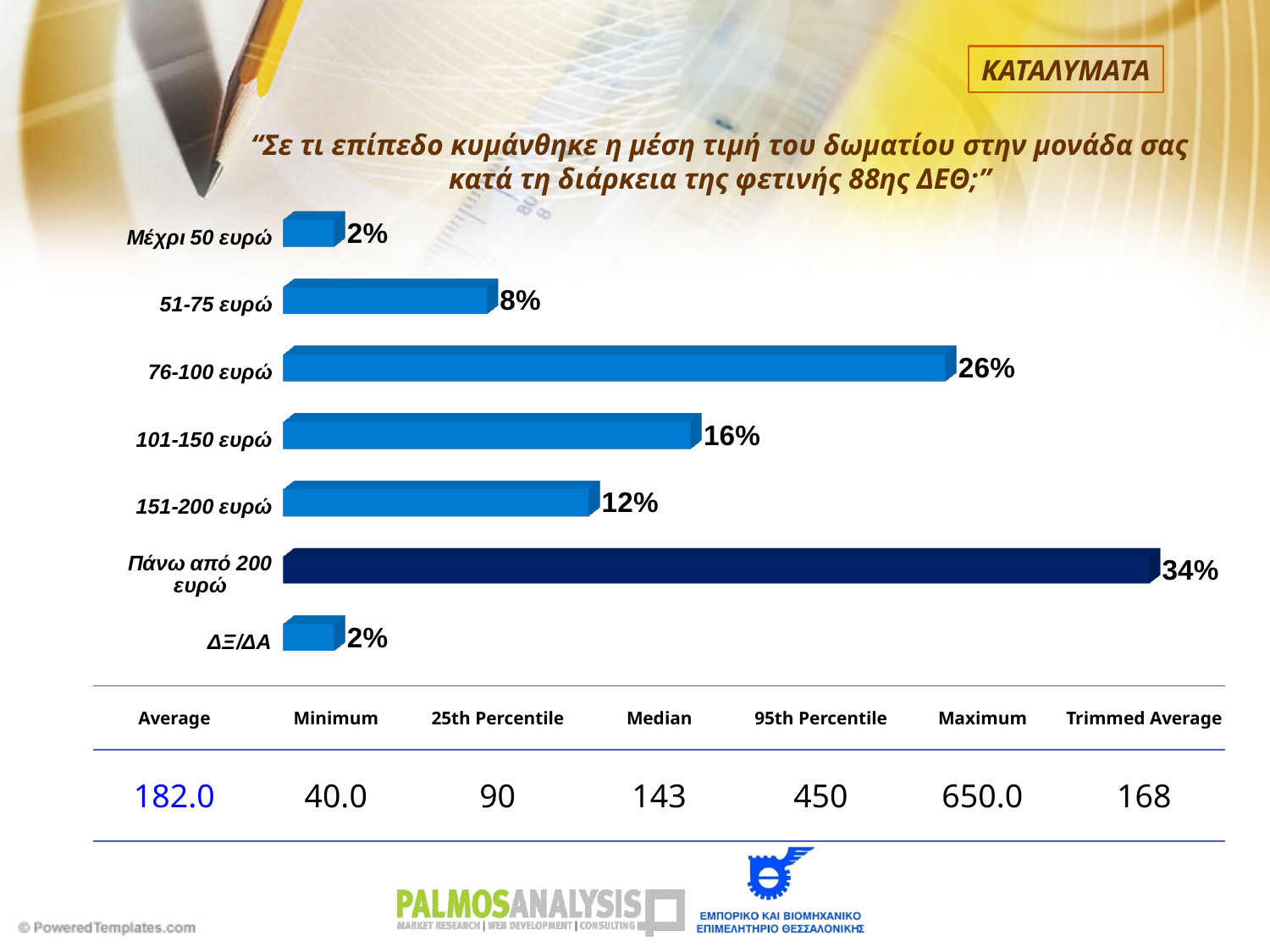
What is the lowest percentage value shown in the chart? 2% How many categories are shown in the bar chart? 7 What percentage is shown for the category 76-100 ευρώ? 26% Which is larger, the value for 76-100 ευρώ or the value for 101-150 ευρώ? 76-100 ευρώ What percentage is shown for the category 51-75 ευρώ? 8% What is the difference in percentage points between 101-150 ευρώ and 151-200 ευρώ? 4 What type of chart is shown on the slide? Bar chart Which bar in the chart is drawn in a darker blue than the others? Πάνω από 200 ευρώ Which category has the highest percentage in the chart? Πάνω από 200 ευρώ What is the difference in percentage points between Πάνω από 200 ευρώ and 76-100 ευρώ? 8 What percentage is shown for the category 101-150 ευρώ? 16% What percentage is shown for the category 151-200 ευρώ? 12%